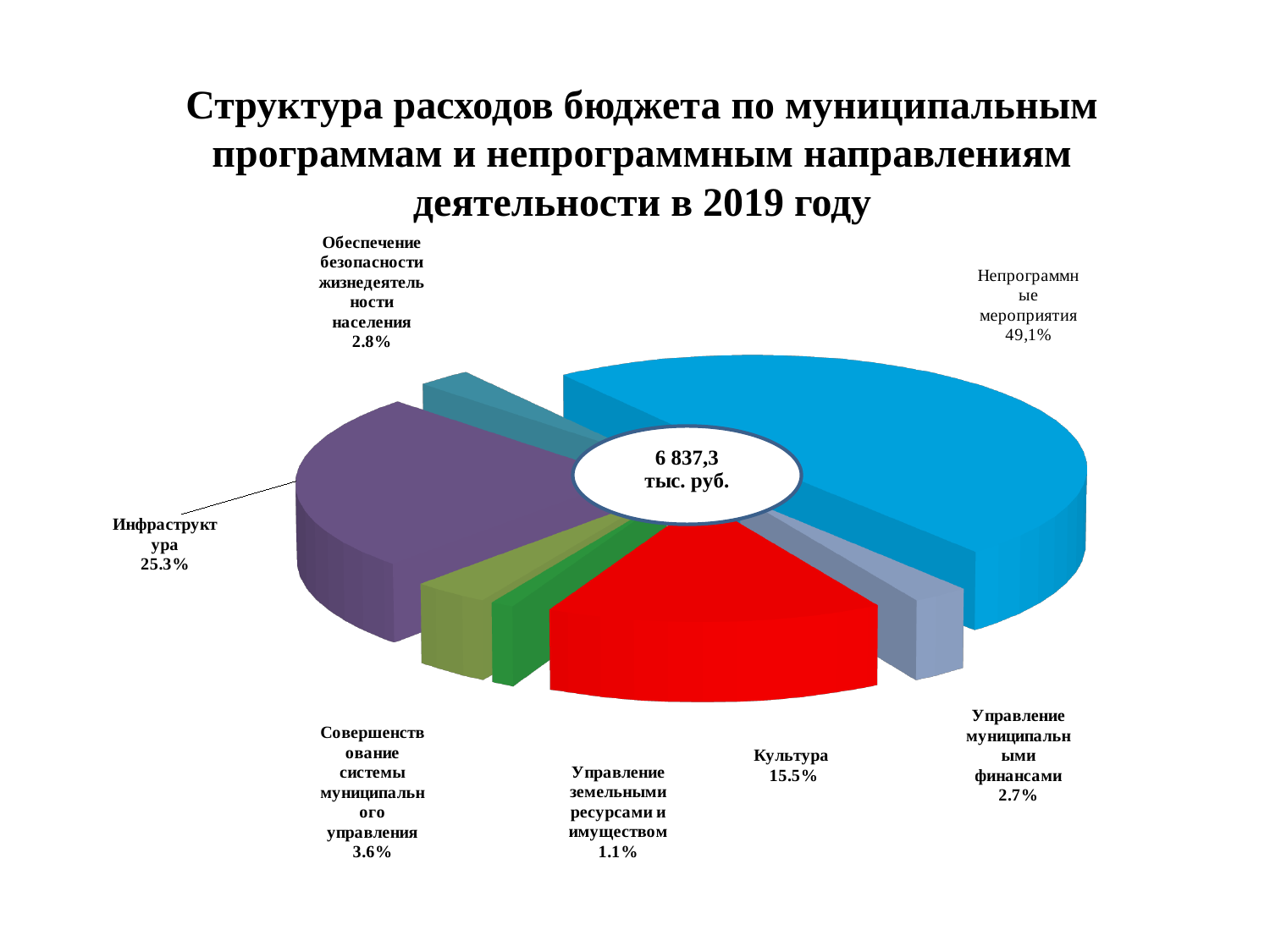
Which is larger: the share for Инфраструктура or the share for Культура? Инфраструктура What share is shown for Управление земельными ресурсами и имуществом? 1.1% What is the difference in percentage points between Непрограммные мероприятия and Инфраструктура? 23.8 What share of the budget expenditure goes to Инфраструктура? 25.3% Which category has the largest share of the pie? Непрограммные мероприятия What share is shown for Совершенствование системы муниципального управления? 3.6% What share of the budget expenditure goes to Культура? 15.5% Which category has the smallest share of the pie? Управление земельными ресурсами и имуществом What share of the budget expenditure goes to Непрограммные мероприятия? 49,1% What kind of chart is shown on the slide? pie chart How many categories (slices) does the pie chart show? 7 What total amount is shown in the centre of the pie chart? 6 837,3 тыс. руб.